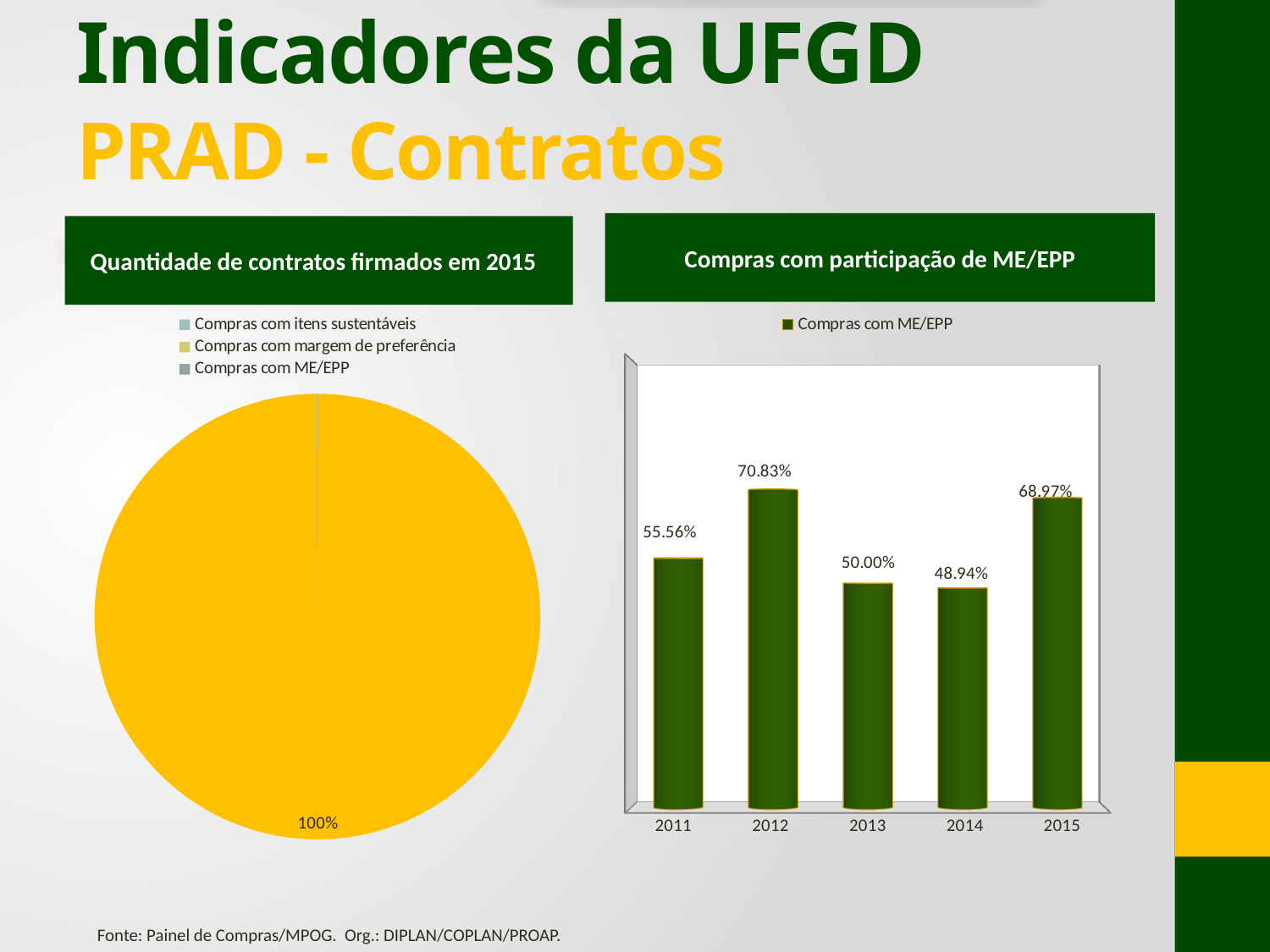
In the 'Compras com participação de ME/EPP' chart, what is the value for 2012? 70.83% What kind of chart is the 'Quantidade de contratos firmados em 2015' chart? pie chart How many entries does the legend of the 'Quantidade de contratos firmados em 2015' chart list? 3 How many years are shown in the 'Compras com participação de ME/EPP' chart? 5 In the 'Compras com participação de ME/EPP' chart, which year has the lowest value? 2014 In the 'Compras com participação de ME/EPP' chart, what is the value for 2015? 68.97% In the 'Compras com participação de ME/EPP' chart, which is larger, the value for 2011 or the value for 2013? 2011 In the 'Compras com participação de ME/EPP' chart, which year has the highest value? 2012 In the 'Quantidade de contratos firmados em 2015' chart, what share is shown on the single visible slice? 100% What kind of chart is the 'Compras com participação de ME/EPP' chart? bar chart In the 'Compras com participação de ME/EPP' chart, what is the value for 2014? 48.94% In the 'Compras com participação de ME/EPP' chart, what is the difference between the values for 2012 and 2011? 15.27%